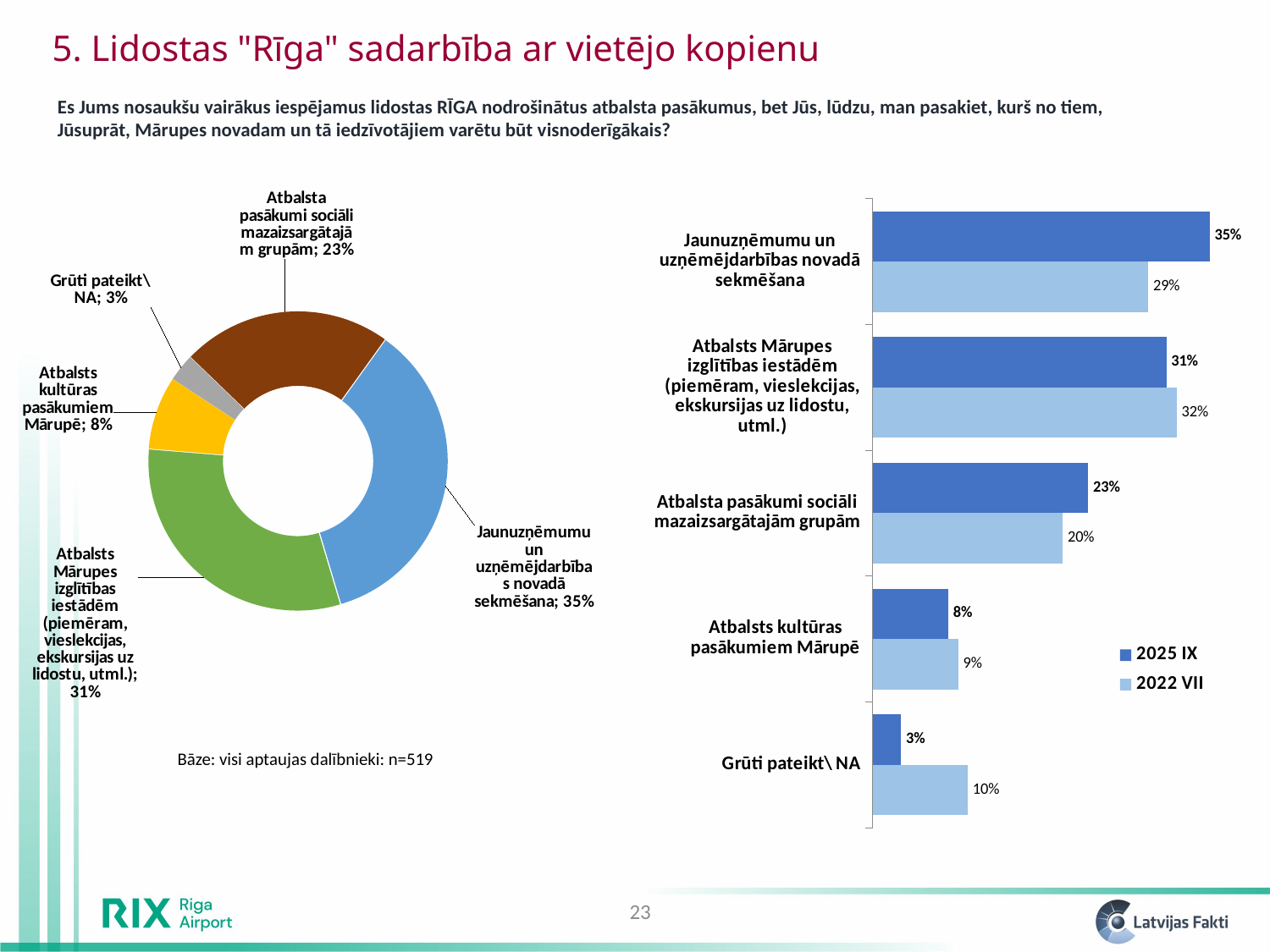
In the doughnut chart on the left, what share is shown for "Jaunuzņēmumu un uzņēmējdarbības novadā sekmēšana"? 35% In the bar chart on the right, which category has the highest 2025 IX value? Jaunuzņēmumu un uzņēmējdarbības novadā sekmēšana What kind of chart is the chart on the right side of the slide? Bar chart In the bar chart on the right, for "Atbalsts kultūras pasākumiem Mārupē", which is larger: the 2025 IX value or the 2022 VII value? 2022 VII What kind of chart is the chart on the left side of the slide? Doughnut chart In the bar chart on the right, what is the 2022 VII value for "Grūti pateikt\ NA"? 10% In the bar chart on the right, what are the two legend entries? 2025 IX and 2022 VII In the bar chart on the right, what is the 2025 IX value for "Atbalsta pasākumi sociāli mazaizsargātajām grupām"? 23% In the bar chart on the right, what is the difference between the 2025 IX and 2022 VII values for "Jaunuzņēmumu un uzņēmējdarbības novadā sekmēšana"? 6 percentage points In the doughnut chart on the left, which category has the smallest share? Grūti pateikt\ NA In the doughnut chart on the left, how many slices are there? 5 In the bar chart on the right, how many series does the legend list? 2